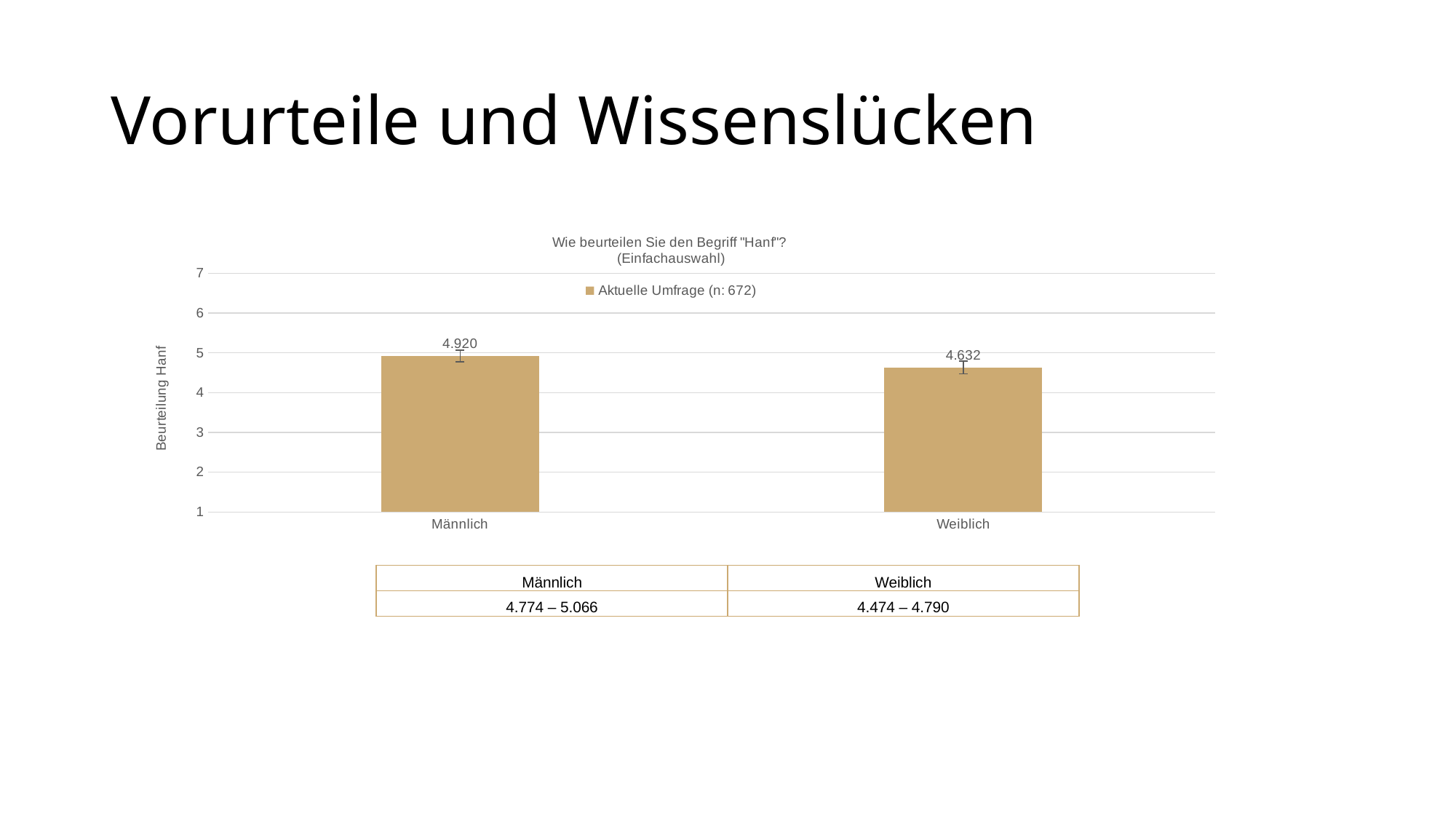
How many series does the legend list? 1 Which category has the lowest value? Weiblich Which category has the highest value? Männlich Is the value for Weiblich greater or less than 5? less What is the label of the y axis? Beurteilung Hanf Is the value for Männlich greater or less than 4? greater What is the difference between the values for Männlich and Weiblich? 0.288 What kind of chart is shown? bar chart Which is larger, the value for Männlich or the value for Weiblich? Männlich What is the value for Weiblich? 4.632 What is the value for Männlich? 4.920 How many categories are shown on the x axis? 2